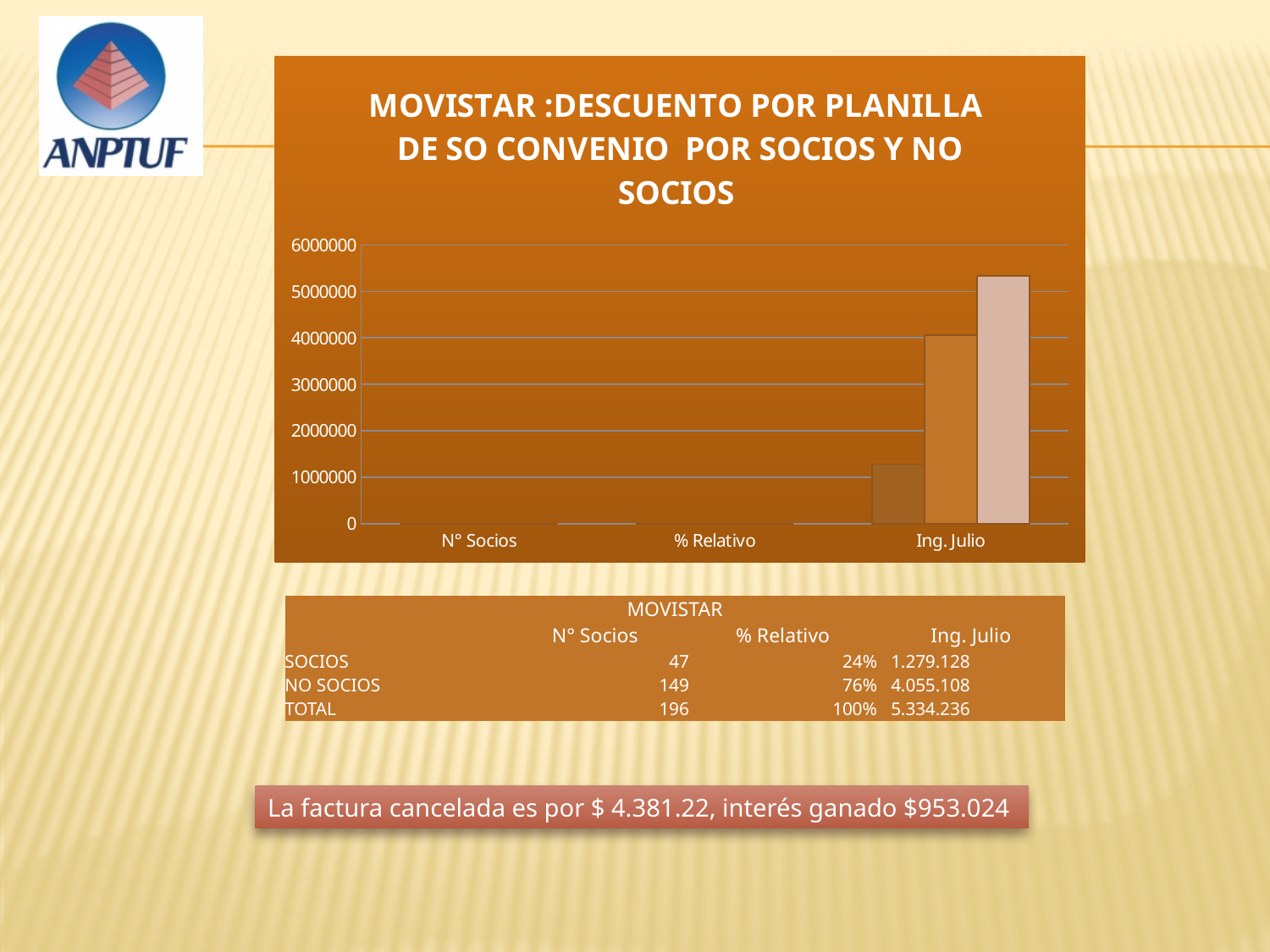
According to the table below the chart, what is the Ing. Julio value for SOCIOS? 1.279.128 Using the table below the chart, what is the difference between the Ing. Julio values for NO SOCIOS and SOCIOS? 2.775.980 What kind of chart is shown on the slide? bar chart Is the value of the middle bar in the Ing. Julio category greater or less than 3000000? greater Is the value of the tallest bar in the Ing. Julio category greater or less than 5000000? greater In the Ing. Julio category, which bar is taller: the lightest-coloured bar or the darkest bar? the lightest-coloured bar According to the table below the chart, what is the N° Socios value for NO SOCIOS? 149 What is the title of the chart? MOVISTAR :DESCUENTO POR PLANILLA DE SO CONVENIO POR SOCIOS Y NO SOCIOS Which category on the x axis has the tallest bars? Ing. Julio How many categories are shown on the x axis of the chart? 3 Is the value of the shortest bar in the Ing. Julio category greater or less than 2000000? less What is the highest value shown on the chart's y axis? 6000000